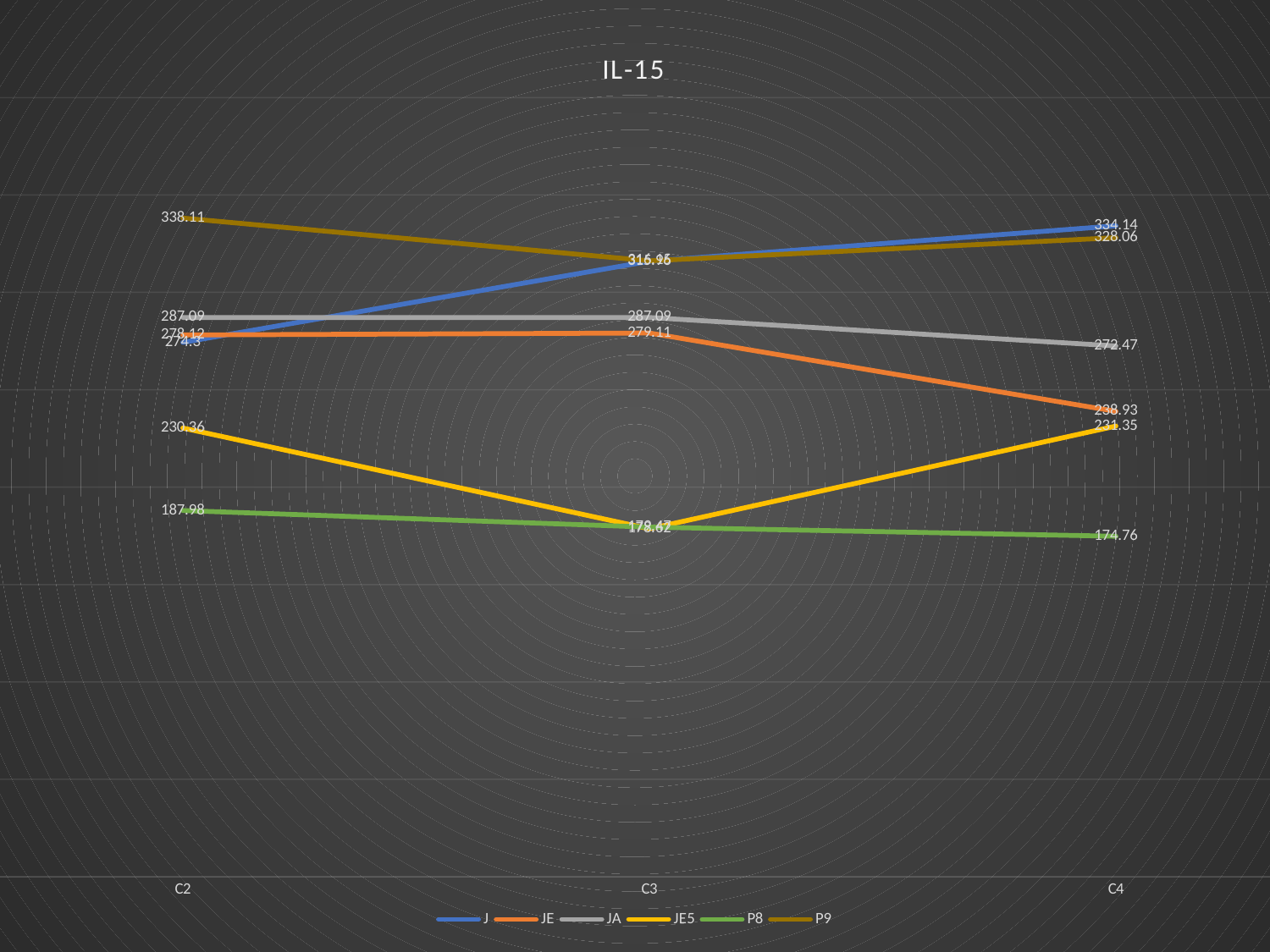
How many series does the legend list? 6 What is the value of P9 at C2? 338.11 Does the P8 series rise or fall from C2 to C4? fall What is the difference between the JA values at C2 and C4? 14.62 Which series has the lowest value at C4? P8 What kind of chart is shown on the slide? line chart What is the value of P8 at C2? 187.98 What is the value of J at C4? 334.14 What is the value of JE at C4? 238.93 Which series has the highest value at C2? P9 How many categories are shown on the x axis? 3 What is the title of the chart? IL-15